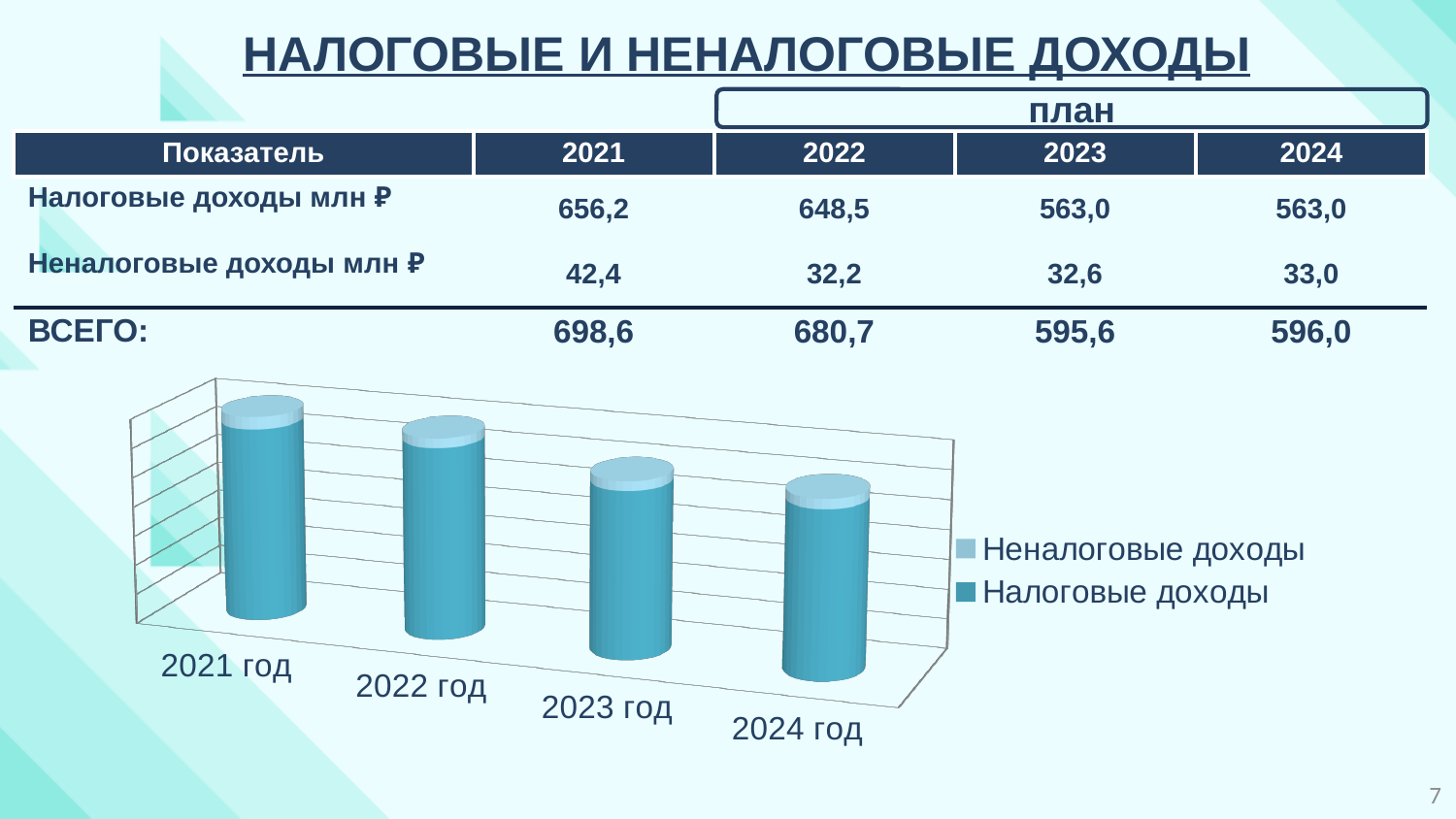
According to the table, what is the value of Неналоговые доходы for 2022? 32,2 By how much do Налоговые доходы in 2021 exceed those in 2022? 7,7 What kind of chart is shown on the slide? bar chart How many series does the chart legend list? 2 Which year has the larger Налоговые доходы, 2021 or 2024? 2021 According to the table, what is the value of Налоговые доходы for 2021? 656,2 Do the stacked bars rise or fall from 2021 год to 2024 год? fall How many years (categories) are shown on the chart's x axis? 4 Which year has the tallest stacked bar on the chart? 2021 год What are the two entries in the chart legend? Неналоговые доходы, Налоговые доходы Which years in the table are marked as план (plan)? 2022, 2023, 2024 What is the total (ВСЕГО) of tax and non-tax revenues for 2023? 595,6